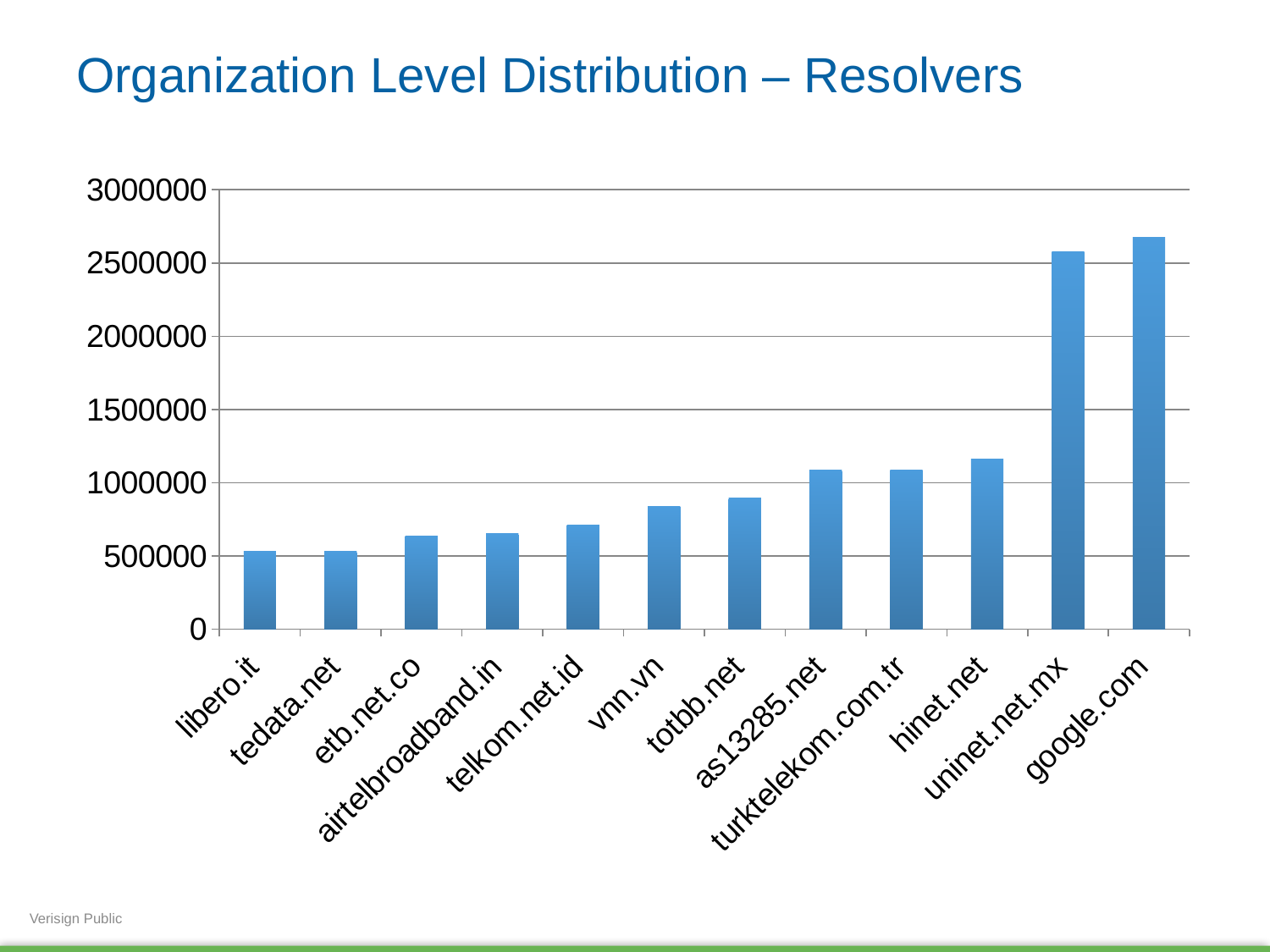
Is the value for vnn.vn greater or less than 1000000? less Which organization has the highest value in the chart? google.com Is the value for uninet.net.mx greater or less than 2000000? greater How many organizations are shown on the x axis of the chart? 12 Is the value for hinet.net greater or less than 1000000? greater Which has the larger value, uninet.net.mx or hinet.net? uninet.net.mx What kind of chart is shown on the slide? bar chart Do the values generally rise or fall moving from left to right along the x axis? rise What is the highest tick value shown on the vertical axis? 3000000 Which has the larger value, hinet.net or vnn.vn? hinet.net